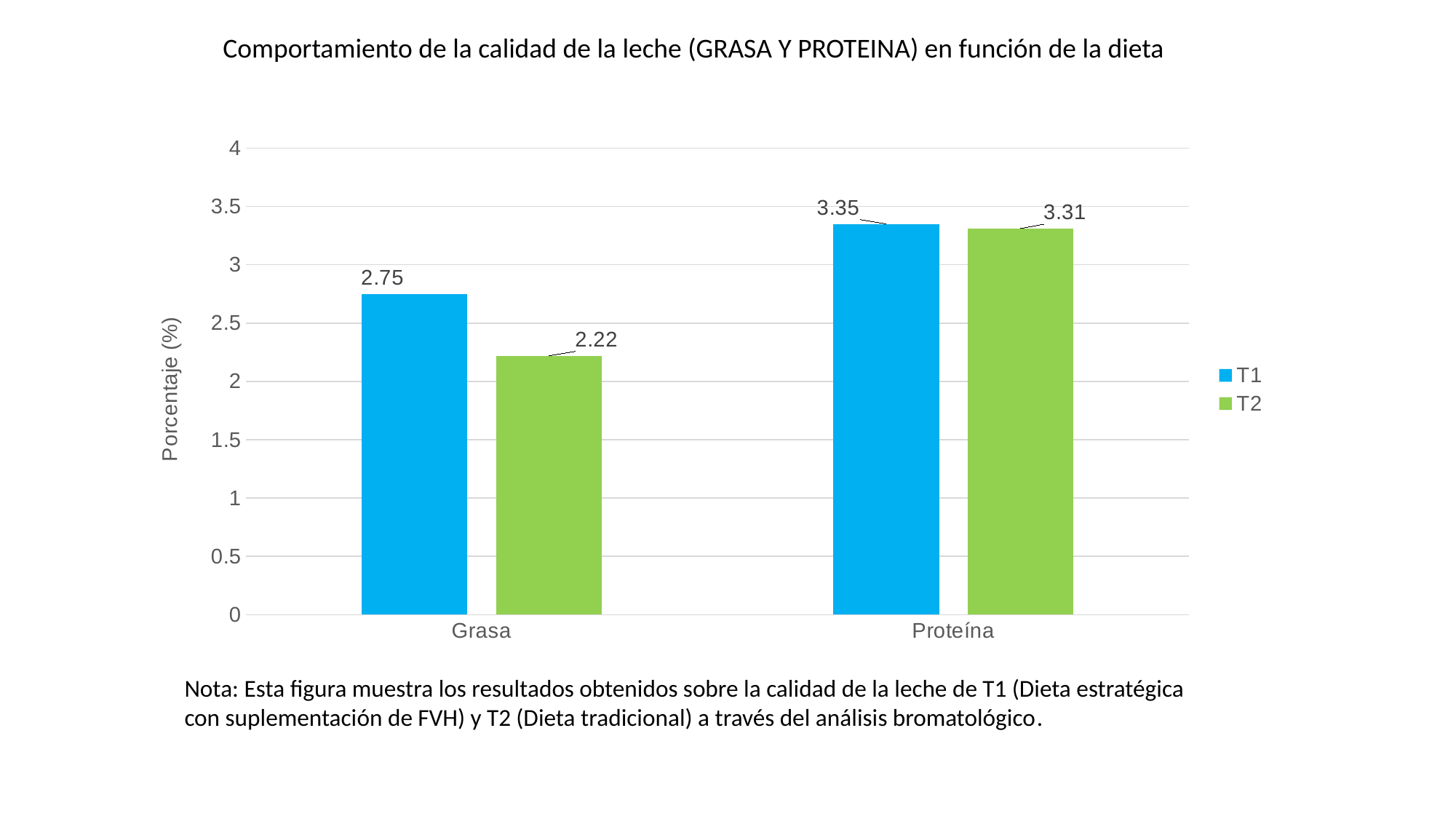
Which category has the lowest T2 value? Grasa What is the T1 value for Proteína? 3.35 Which category has the highest T1 value? Proteína What is the T2 value for Grasa? 2.22 What is the T1 value for Grasa? 2.75 What is the difference between the T1 and T2 values for Grasa? 0.53 What is the difference between the T1 and T2 values for Proteína? 0.04 For Grasa, which series has the larger value, T1 or T2? T1 What is the T2 value for Proteína? 3.31 What kind of chart is shown on the slide? Bar chart How many categories are shown on the x axis? 2 How many series does the legend list? 2